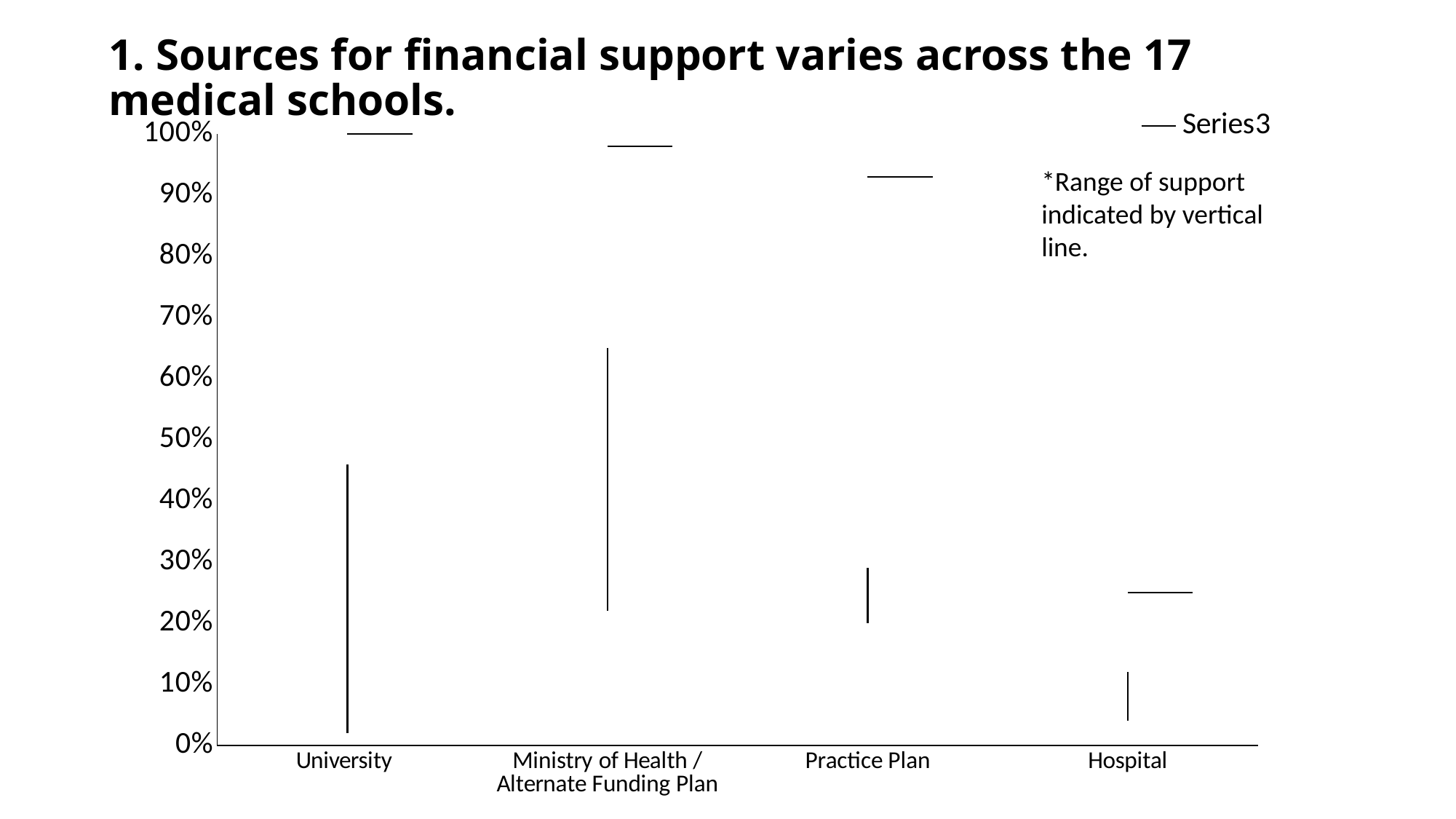
Is the bottom of the vertical range line for Ministry of Health / Alternate Funding Plan greater or less than 10%? greater How many series does the chart legend list? 1 Is the top of the vertical range line for Ministry of Health / Alternate Funding Plan greater or less than 60%? greater Is the top of the vertical range line for Hospital greater or less than 20%? less According to the note on the slide, what does the vertical line in the chart indicate? Range of support Which category has the vertical range line with the lowest top value? Hospital How many categories are shown on the x axis of the chart? 4 What is the name of the series shown in the chart legend? Series3 Does the vertical range line for University or for Hospital reach a higher value? University Which category has the vertical range line reaching the highest value? Ministry of Health / Alternate Funding Plan